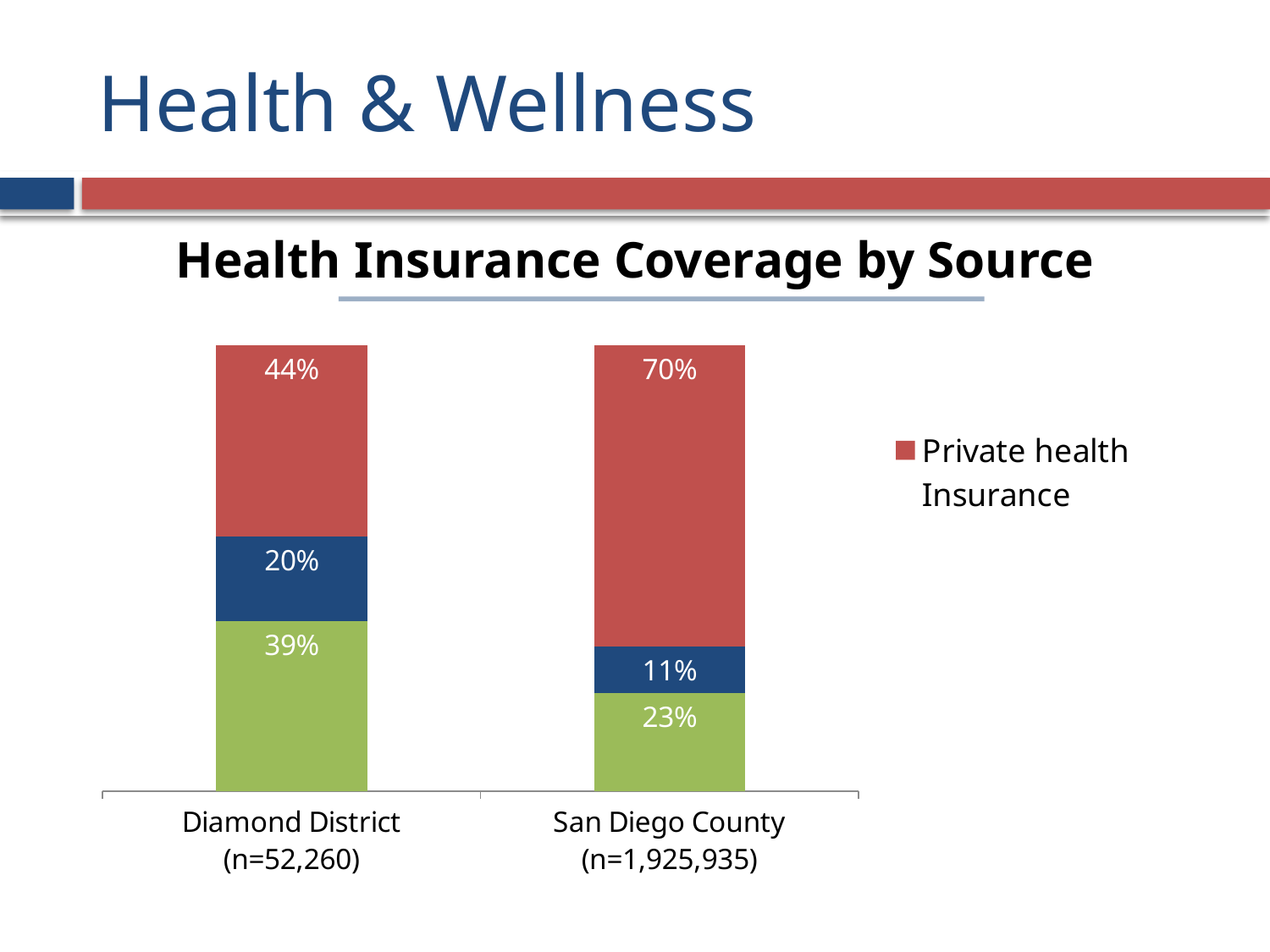
What is the Private health Insurance value for Diamond District? 44% Is the Private health Insurance value larger for Diamond District or for San Diego County? San Diego County What is the title of the chart? Health Insurance Coverage by Source What is the Private health Insurance value for San Diego County? 70% What is the value printed on the bottom segment of the Diamond District bar? 39% What is the value printed on the middle segment of the San Diego County bar? 11% Which category has the higher Private health Insurance value? San Diego County How many categories are shown on the x axis? 2 What is the difference between the Private health Insurance values for San Diego County and Diamond District? 26 percentage points What kind of chart is shown on the slide? Stacked bar chart Which category has the lower Private health Insurance value? Diamond District How many series does the legend list? 1